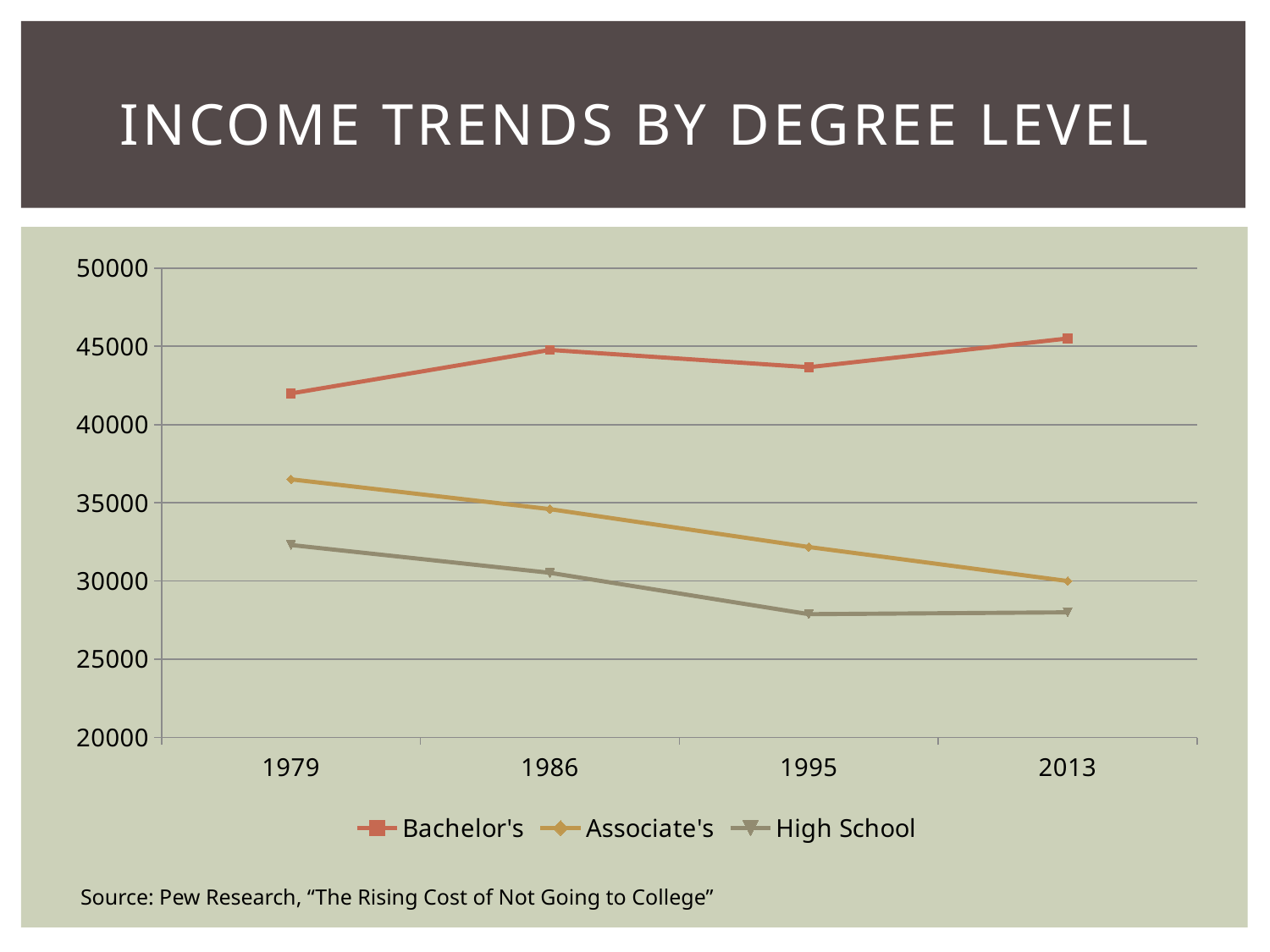
How many series does the legend list? 3 Which degree level has the lowest income in 1979? High School Which degree level has the highest income in 2013? Bachelor's Is the value for Associate's in 1995 greater or less than 35000? less What kind of chart is shown on the slide? Line chart How many years are plotted along the x axis? 4 What is the title of the chart slide? Income Trends by Degree Level Does the Associate's line rise or fall from 1979 to 2013? Fall Is the value for High School in 1995 greater or less than 30000? less Is the value for Associate's in 1979 greater or less than 35000? greater In 1986, which is larger: the value for Associate's or the value for High School? Associate's